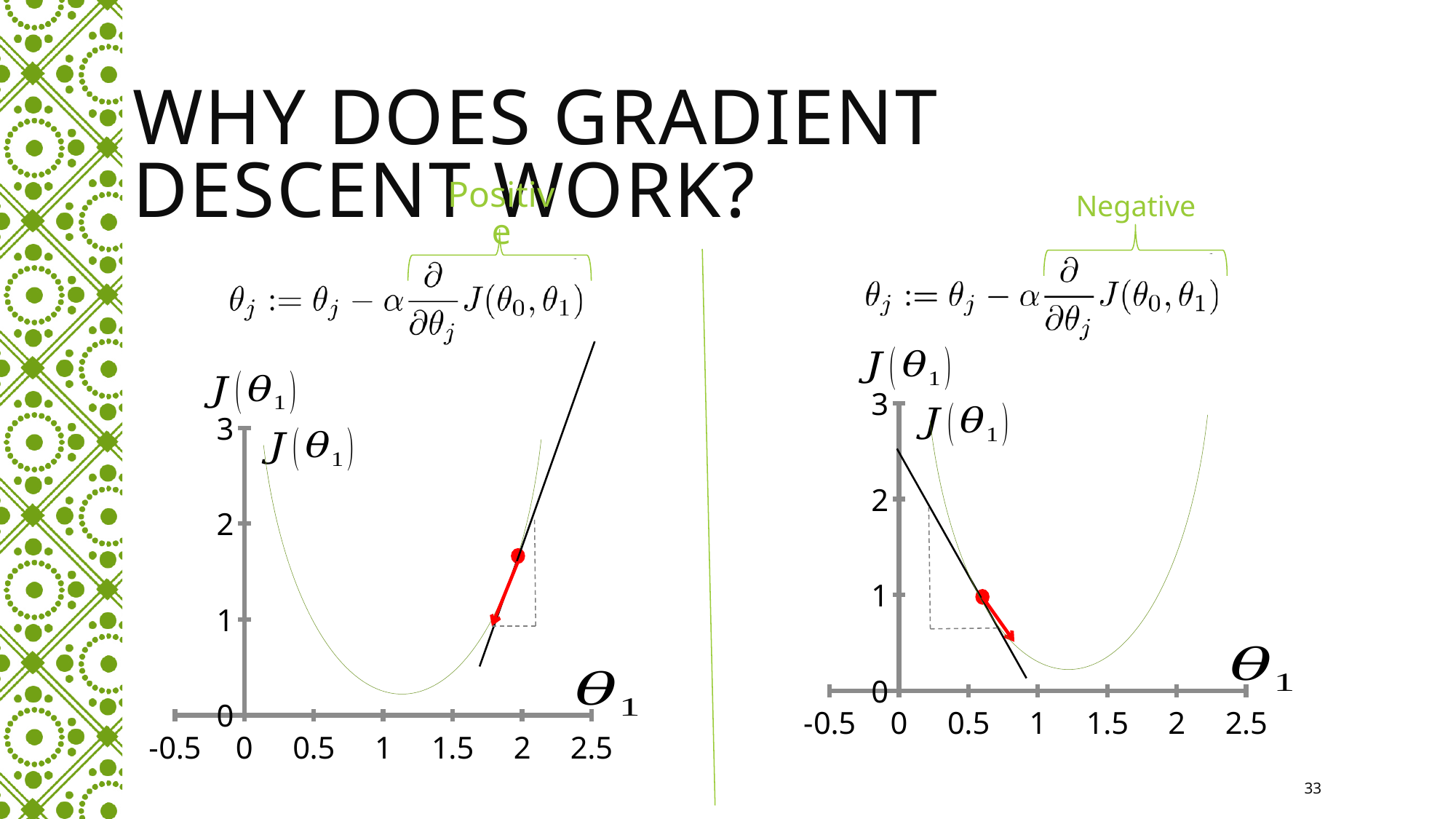
On the right chart, does the curve rise or fall as θ1 increases from 1.5 to 2? rise On the right chart, is the lowest J(θ1) value of the curve greater or less than 1? less On the left chart, is the θ1 value of the red point greater or less than 1.5? greater What is the label on the vertical axis of the left chart? J(θ1) On the left chart, is the J(θ1) value at the red point greater or less than 1? greater What is the highest tick value shown on the horizontal axis of the left chart? 2.5 What is the label on the horizontal axis of the right chart? θ1 What kind of chart is the left chart? line chart On the left chart, does the curve rise or fall as θ1 increases from 0 to 1? fall How many charts are shown on the slide? 2